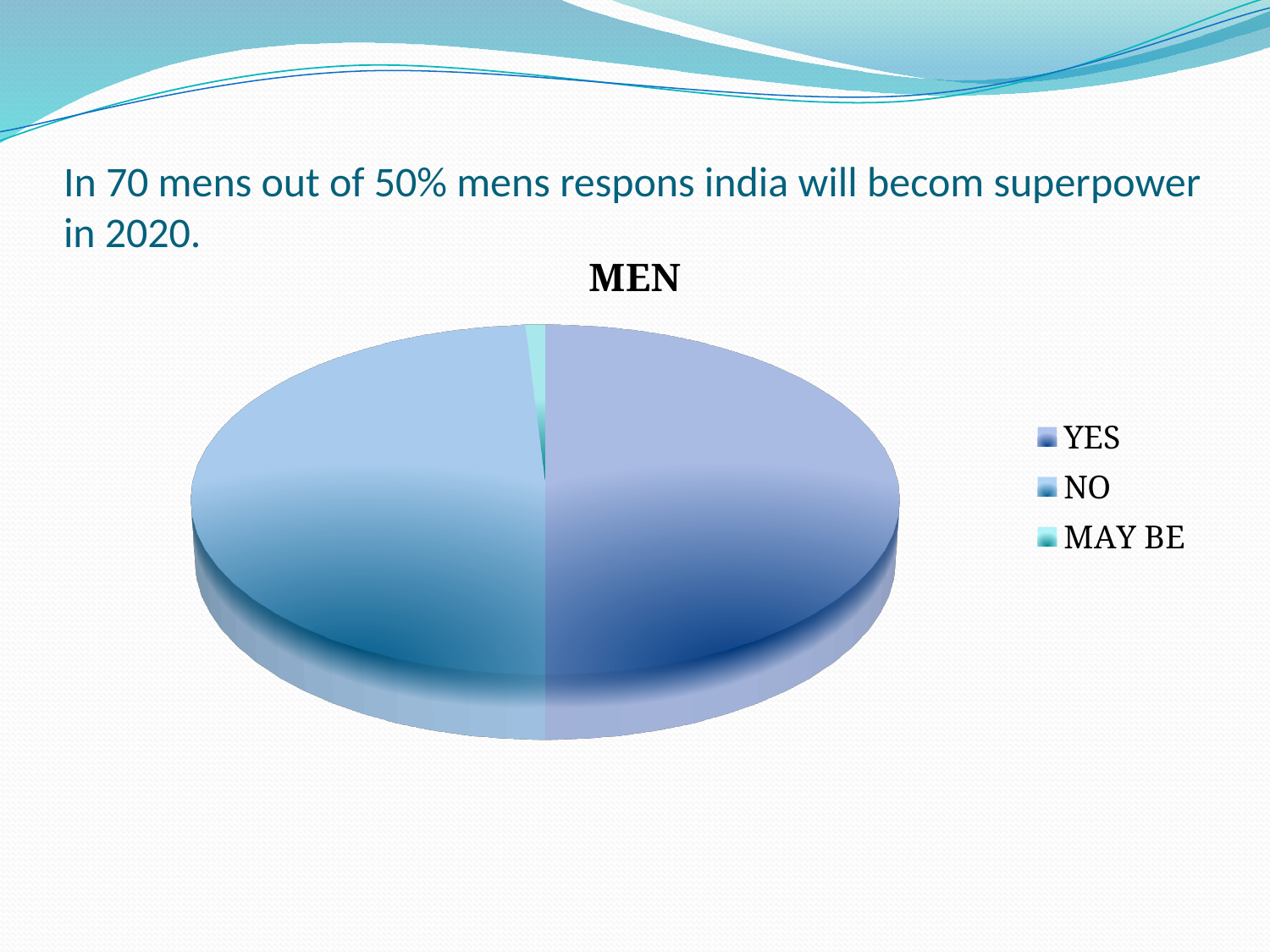
Which category has the smallest slice of the pie? MAY BE How many categories does the pie chart have? 3 What is the title of the chart? MEN How many entries does the legend list? 3 What are the three categories listed in the legend? YES, NO, MAY BE What kind of chart is shown on the slide? pie chart Which slice is larger, YES or MAY BE? YES Which slice is larger, NO or MAY BE? NO